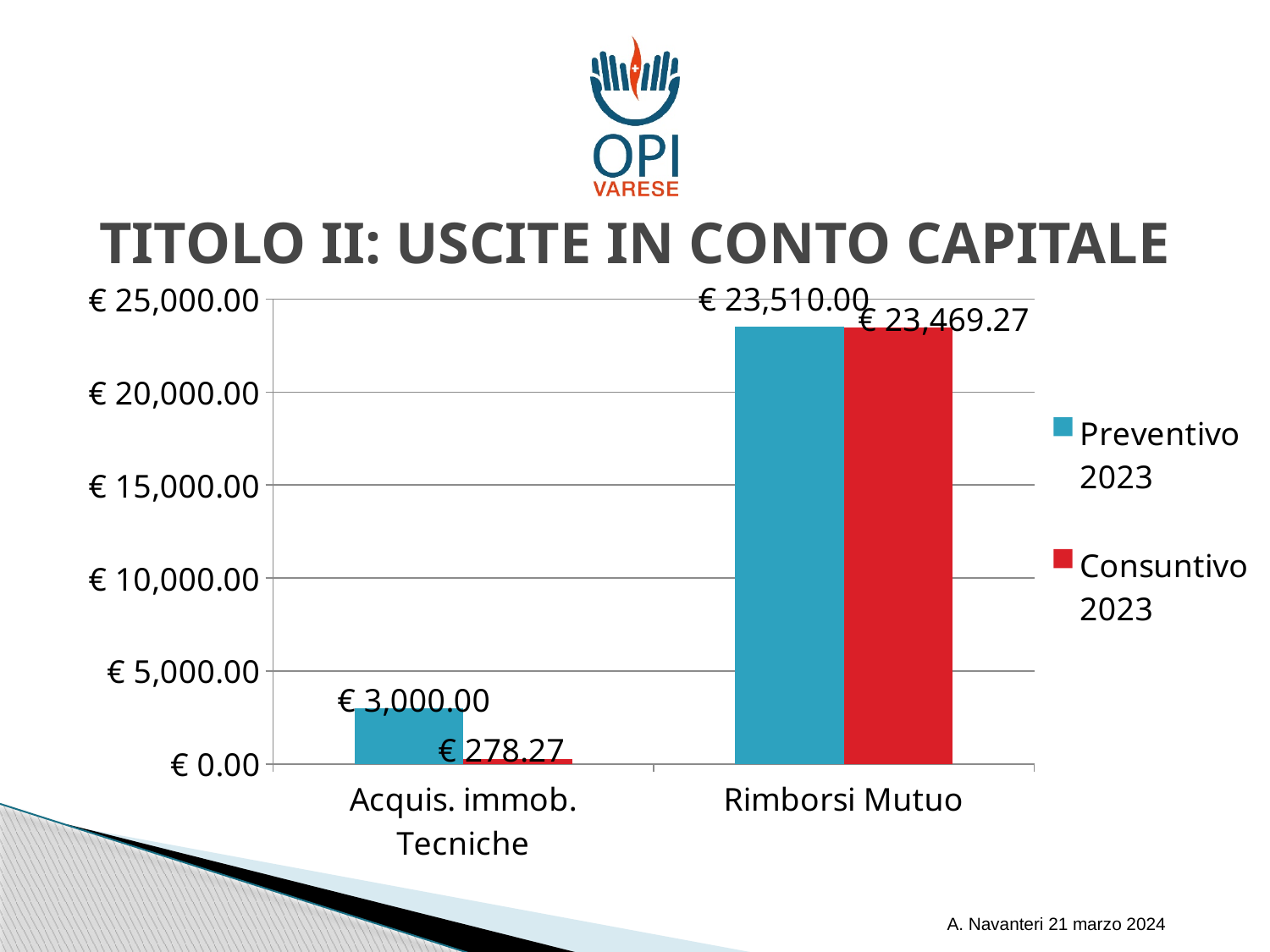
What is the difference between the Preventivo 2023 and Consuntivo 2023 values for Rimborsi Mutuo? € 40.73 How many categories are shown on the x axis? 2 Which category has the lowest Consuntivo 2023 value? Acquis. immob. Tecniche Which category has the highest Preventivo 2023 value? Rimborsi Mutuo What is the difference between the Preventivo 2023 and Consuntivo 2023 values for Acquis. immob. Tecniche? € 2,721.73 What kind of chart is shown on the slide? Bar chart What is the Consuntivo 2023 value for Acquis. immob. Tecniche? € 278.27 What is the Preventivo 2023 value for Acquis. immob. Tecniche? € 3,000.00 What is the Preventivo 2023 value for Rimborsi Mutuo? € 23,510.00 How many series does the legend list? 2 Which is larger for Acquis. immob. Tecniche: Preventivo 2023 or Consuntivo 2023? Preventivo 2023 What is the Consuntivo 2023 value for Rimborsi Mutuo? € 23,469.27